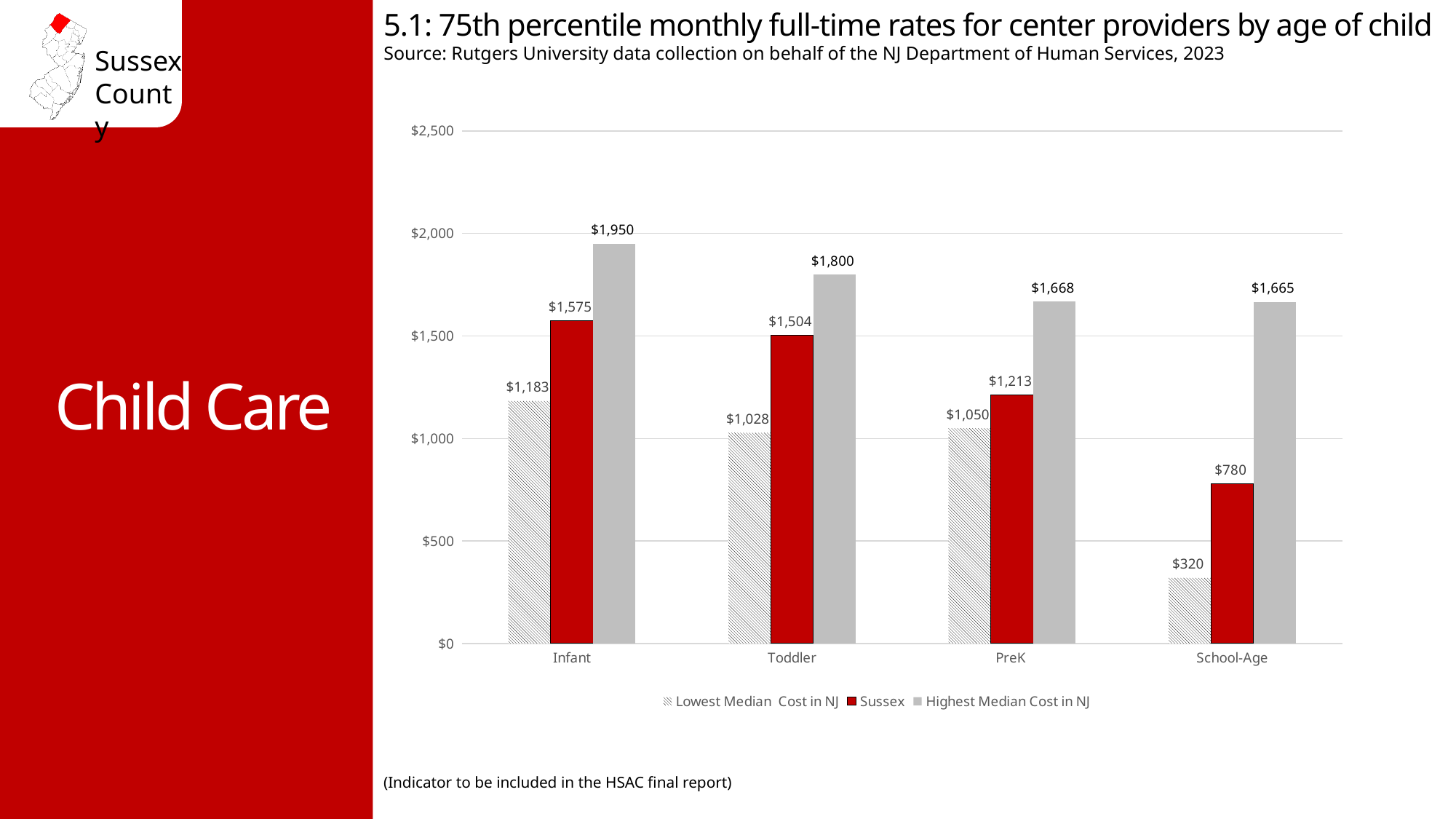
Which age category has the lowest Lowest Median Cost in NJ value? School-Age What kind of chart is shown on the slide? bar chart What is the Lowest Median Cost in NJ for School-Age? $320 Which series is shown in red? Sussex What is the difference between the Highest Median Cost in NJ and the Sussex value for PreK? $455 Is the Sussex value for School-Age greater or less than $1,000? less How many series does the legend list? 3 Which age category has the highest Sussex value? Infant Which is larger for Toddler: the Sussex value or the Lowest Median Cost in NJ? Sussex What is the Highest Median Cost in NJ for Toddler? $1,800 How many age categories are shown on the x axis? 4 What is the Sussex value for Infant? $1,575